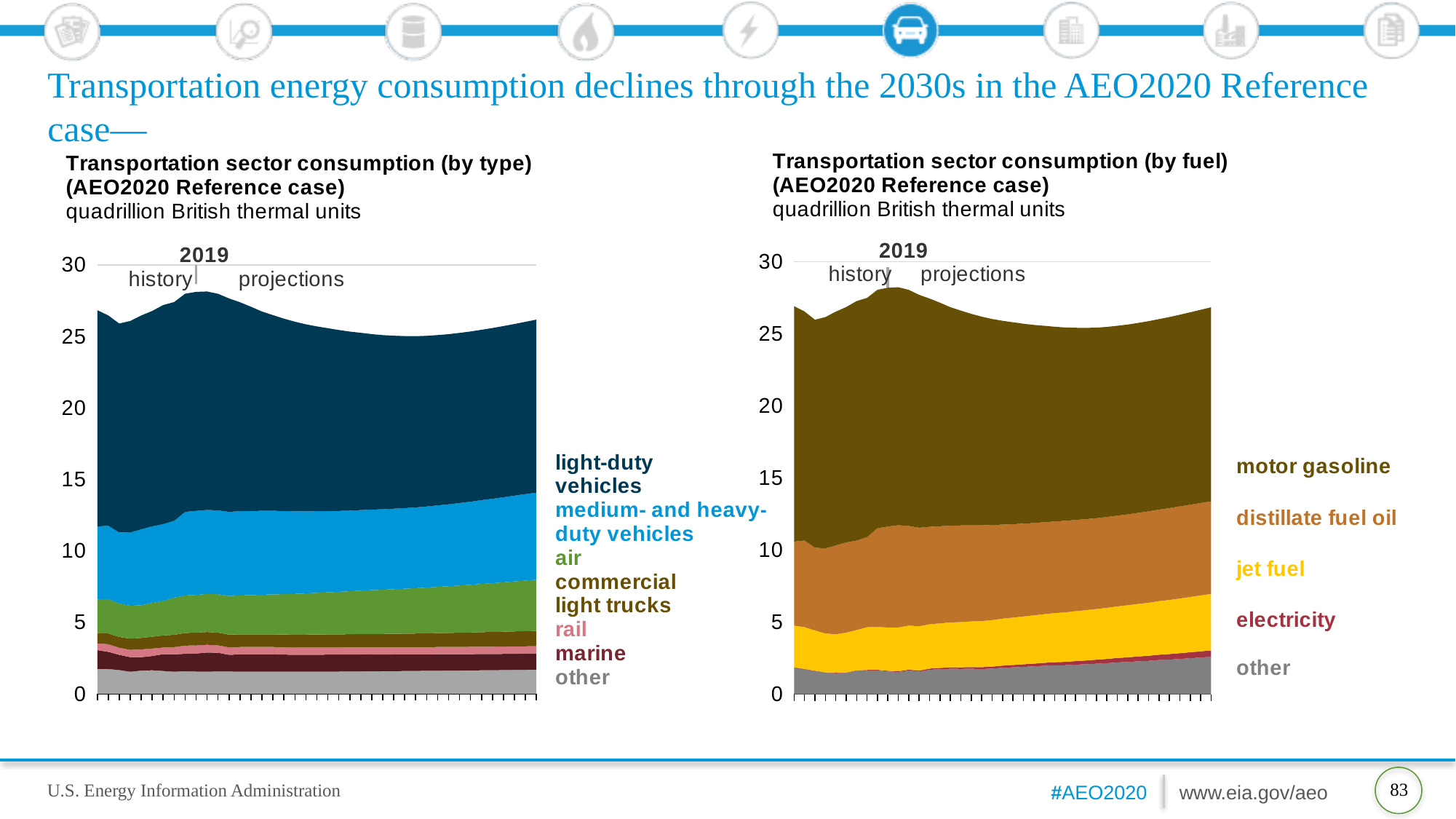
In the left chart, 'Transportation sector consumption (by type)', is the total consumption in 2019 greater or less than 25? greater In the right chart, 'Transportation sector consumption (by fuel)', which fuel has the thinnest band? electricity In the right chart, 'Transportation sector consumption (by fuel)', does the electricity band grow or shrink over the projection period? grow In the left chart, 'Transportation sector consumption (by type)', which series accounts for the largest share of consumption? light-duty vehicles What year separates history from projections in both charts? 2019 What kind of chart is the left chart, 'Transportation sector consumption (by type)'? stacked area chart How many series does the legend of the left chart, 'Transportation sector consumption (by type)', list? 7 How many series does the legend of the right chart, 'Transportation sector consumption (by fuel)', list? 5 In the left chart, 'Transportation sector consumption (by type)', does total consumption rise or fall in the years immediately after 2019? fall In the right chart, 'Transportation sector consumption (by fuel)', which fuel accounts for the largest share of consumption? motor gasoline In the right chart, 'Transportation sector consumption (by fuel)', is the total consumption at its 2019 peak greater or less than 30? less What unit of measurement is used on both charts? quadrillion British thermal units